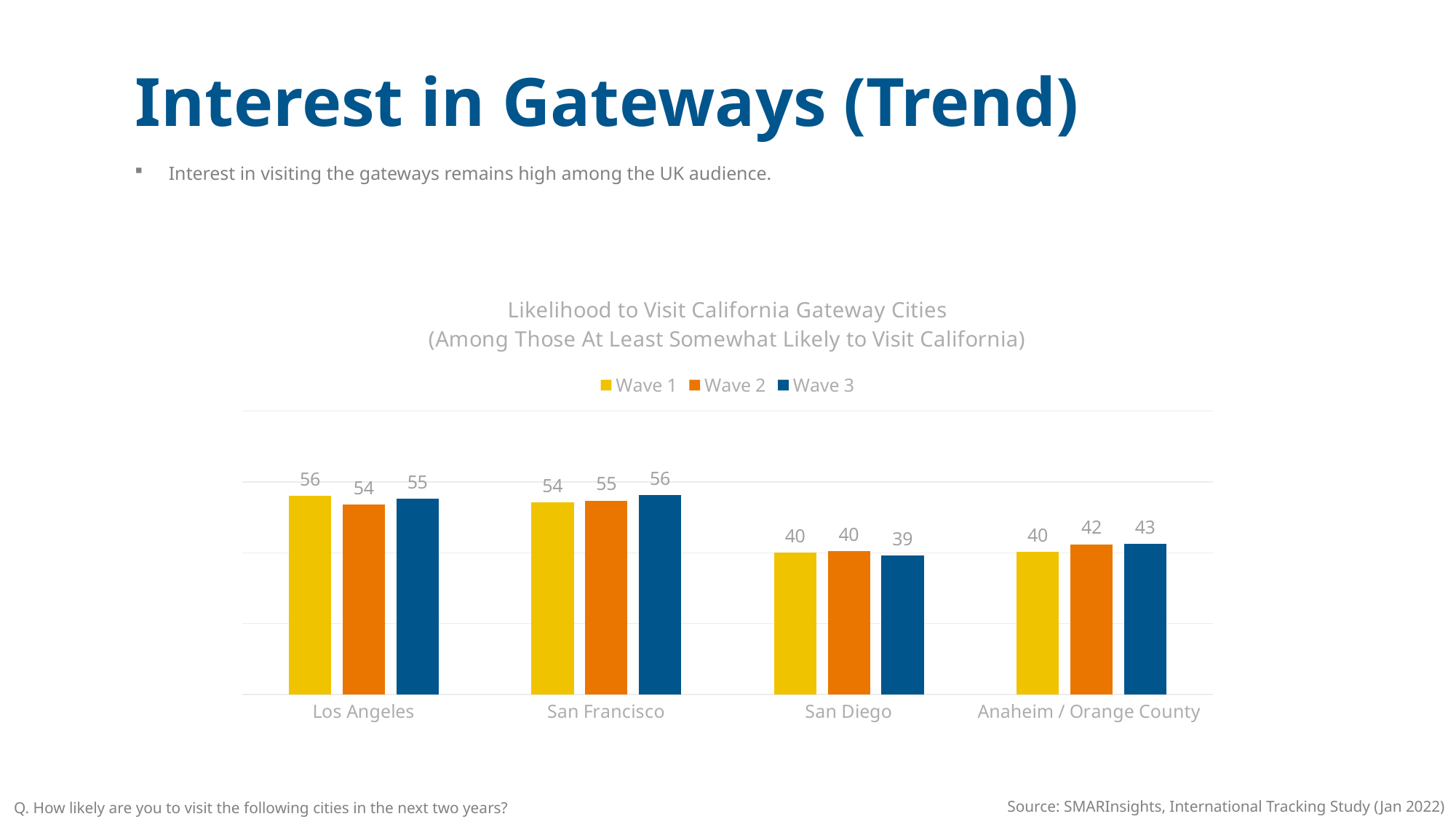
What is the Wave 1 value for Los Angeles? 56 What is the Wave 3 value for San Francisco? 56 Which city has the highest Wave 3 value? San Francisco Is the Wave 1 value for Los Angeles larger than the Wave 1 value for San Diego? Yes How many series does the legend list? 3 What is the difference between the Wave 3 values for San Francisco and San Diego? 17 What kind of chart is shown? Bar chart Do the values for Anaheim / Orange County rise or fall from Wave 1 to Wave 3? Rise How many cities are shown on the x axis? 4 What is the Wave 2 value for Anaheim / Orange County? 42 Which city has the lowest Wave 3 value? San Diego What is the Wave 3 value for San Diego? 39